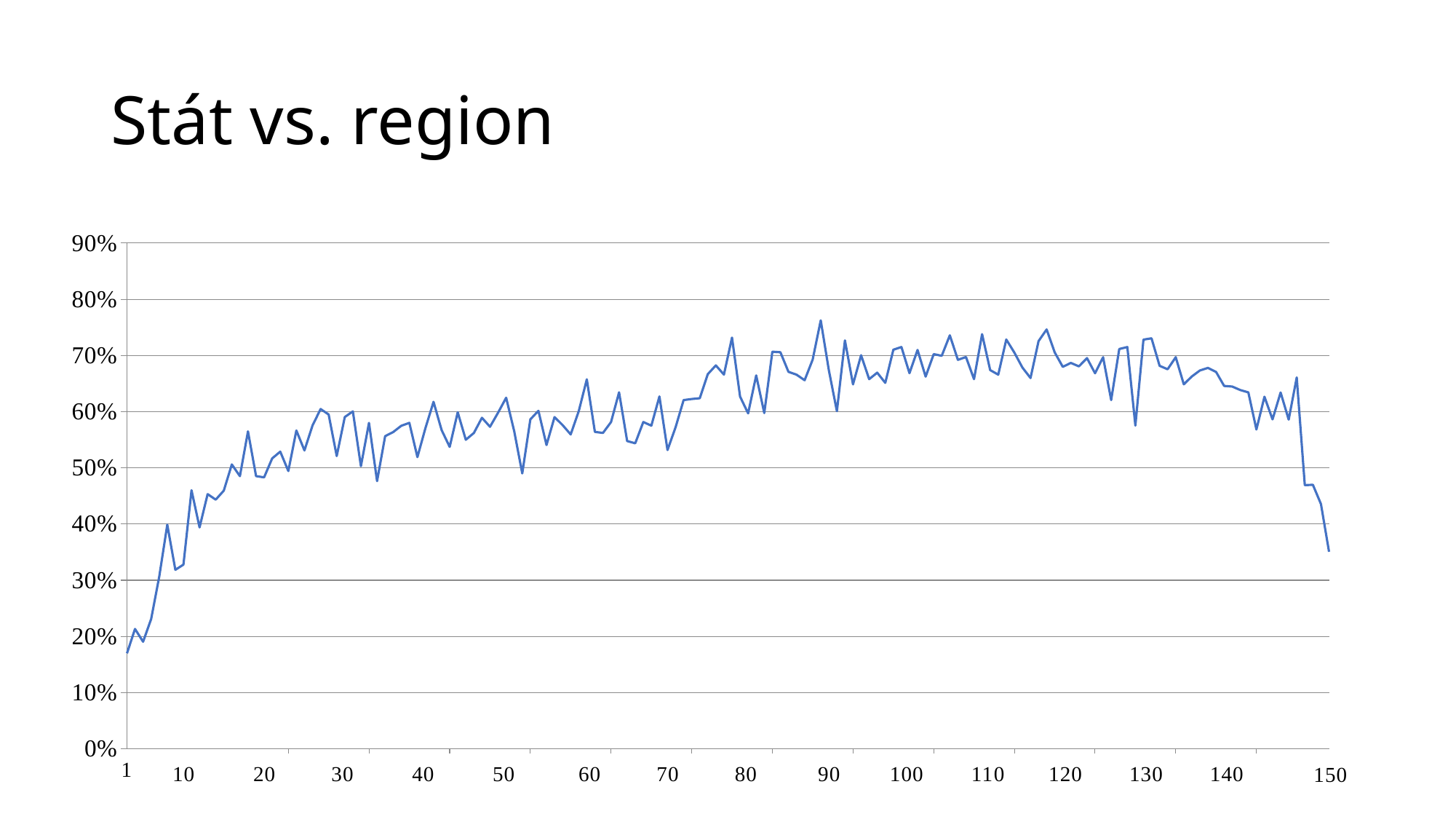
Is the value at x = 150 greater or less than 40%? less At which x value does the line reach its lowest point? 1 Is the value at x = 1 greater or less than 20%? less What kind of chart is shown on the slide? line chart Is the value at x = 10 greater or less than 30%? greater What is the title of the slide containing the chart? Stát vs. region How many data points does the x axis span, from its first to its last label? 150 Do the values rise or fall between x = 140 and x = 150? fall Do the values rise or fall between x = 1 and x = 10? rise How many lines are plotted on the chart? 1